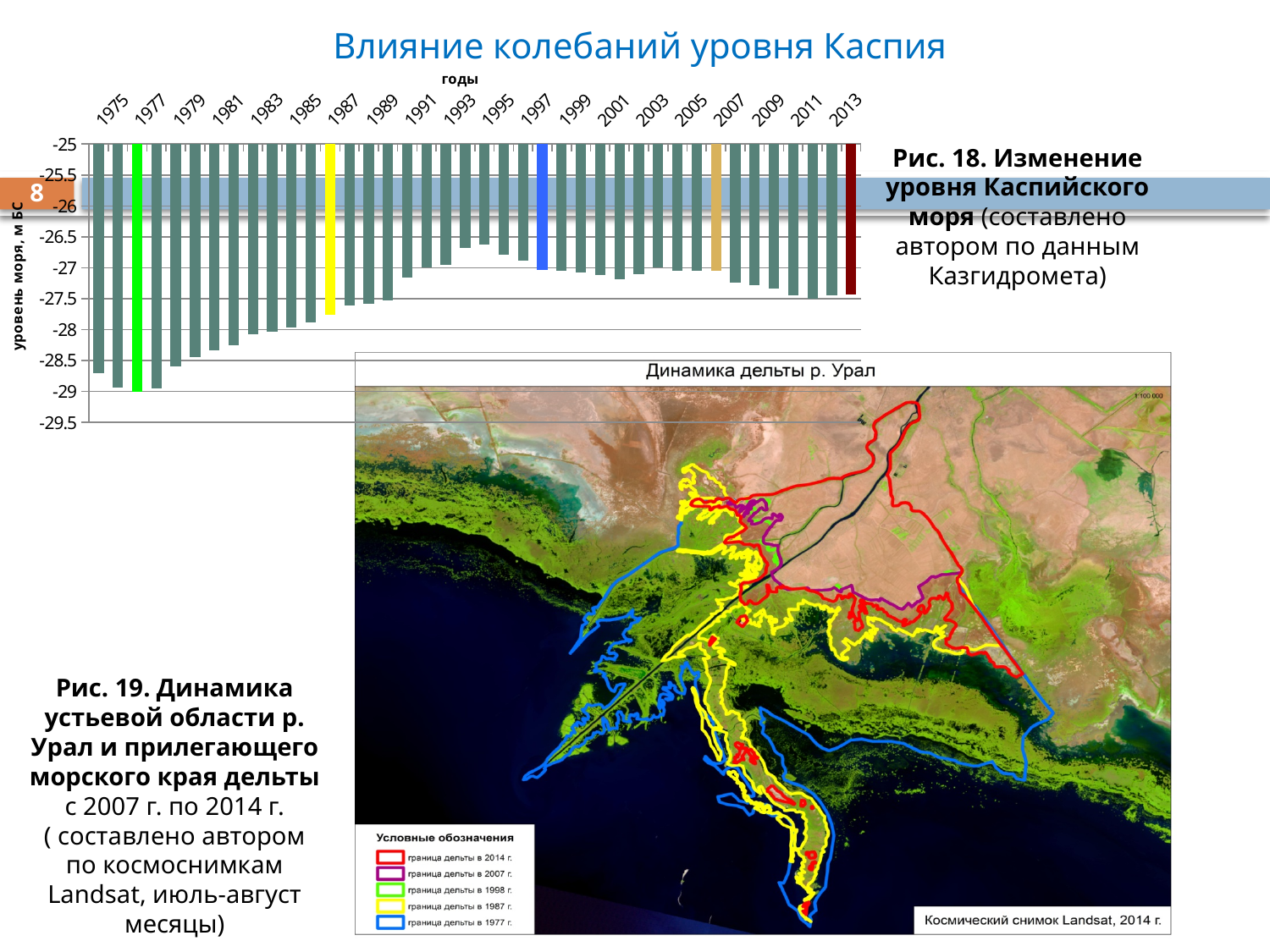
In the bar chart of Caspian Sea level, does the sea level rise or fall from 1995 to 2014? fall In the bar chart of Caspian Sea level, what is the title of the horizontal axis? годы In the bar chart of Caspian Sea level, what is the title of the vertical axis? уровень моря, м БС In the bar chart of Caspian Sea level, which year has the higher sea level, 1987 or 2014? 2014 In the bar chart of Caspian Sea level, does the sea level rise or fall from 1977 to 1995? rise In the bar chart of Caspian Sea level, is the value for 1987 (yellow bar) greater or less than -27.5? less In the bar chart of Caspian Sea level, how many year labels are shown along the horizontal axis? 20 In the bar chart of Caspian Sea level, is the value for 1995 greater or less than -27? greater In the bar chart of Caspian Sea level, which year has the higher sea level, 1977 or 1995? 1995 In the bar chart of Caspian Sea level, is the value for the last bar (2014, dark red) greater or less than -27? less What kind of chart is used in Рис. 18 to show the Caspian Sea level? bar chart